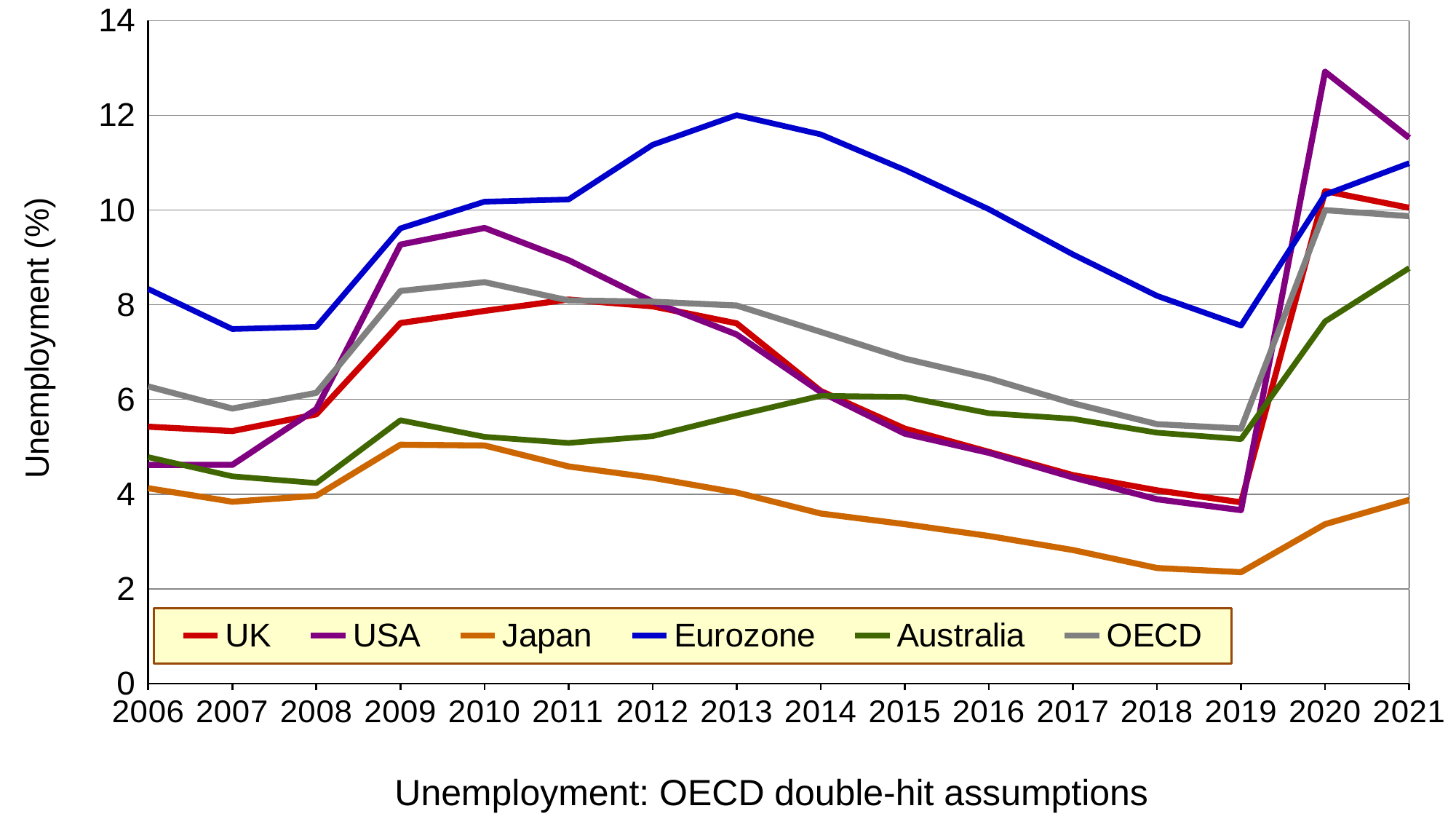
Which series has the lowest unemployment rate in 2019? Japan How many years are shown along the x axis? 16 Does the Japan line rise or fall from 2010 to 2019? fall Is the value for Japan in 2018 greater or less than 4? less What kind of chart is shown on the slide? line chart Which is larger in 2020, the value for USA or the value for UK? USA Is the value for Eurozone in 2013 greater or less than 10? greater Does the Eurozone line rise or fall from 2013 to 2019? fall How many series does the legend list? 6 Which series has the highest unemployment rate in 2013? Eurozone What is the title of the chart? Unemployment: OECD double-hit assumptions Which series has the highest unemployment rate in 2020? USA